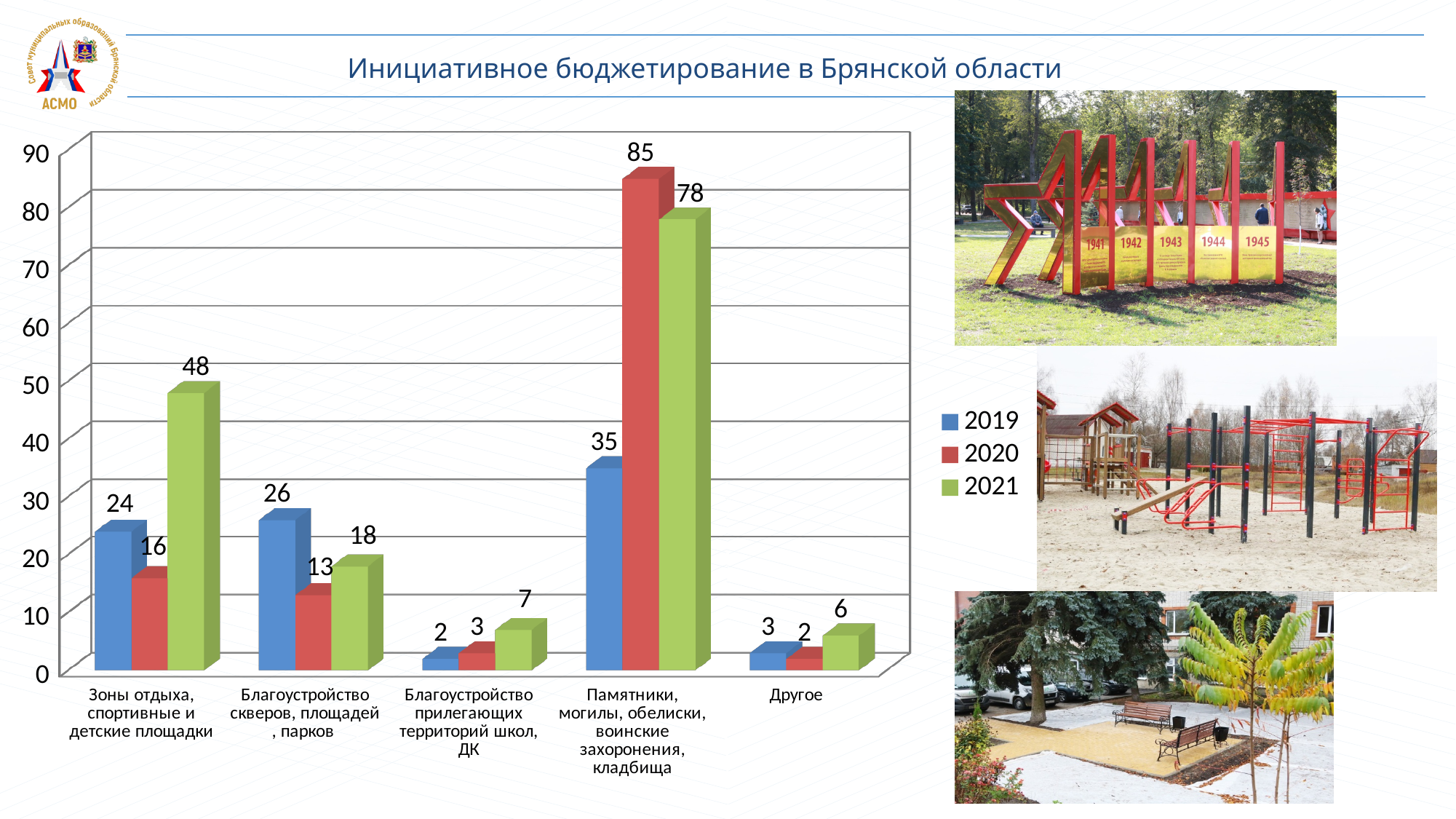
How many series does the legend list? 3 For «Благоустройство скверов, площадей, парков», which year has the larger value: 2019 or 2021? 2019 Which category has the highest 2021 value? Памятники, могилы, обелиски, воинские захоронения, кладбища What is the 2020 value for «Памятники, могилы, обелиски, воинские захоронения, кладбища»? 85 How many categories are shown on the x axis? 5 Which colour represents the 2020 series in the legend? red Is the 2019 value for «Памятники, могилы, обелиски, воинские захоронения, кладбища» greater or less than 30? greater What is the difference between the 2020 and 2021 values for «Памятники, могилы, обелиски, воинские захоронения, кладбища»? 7 What is the 2019 value for «Благоустройство скверов, площадей, парков»? 26 What kind of chart is shown on the slide? bar chart Which category has the lowest 2020 value? Другое What is the 2021 value for «Зоны отдыха, спортивные и детские площадки»? 48